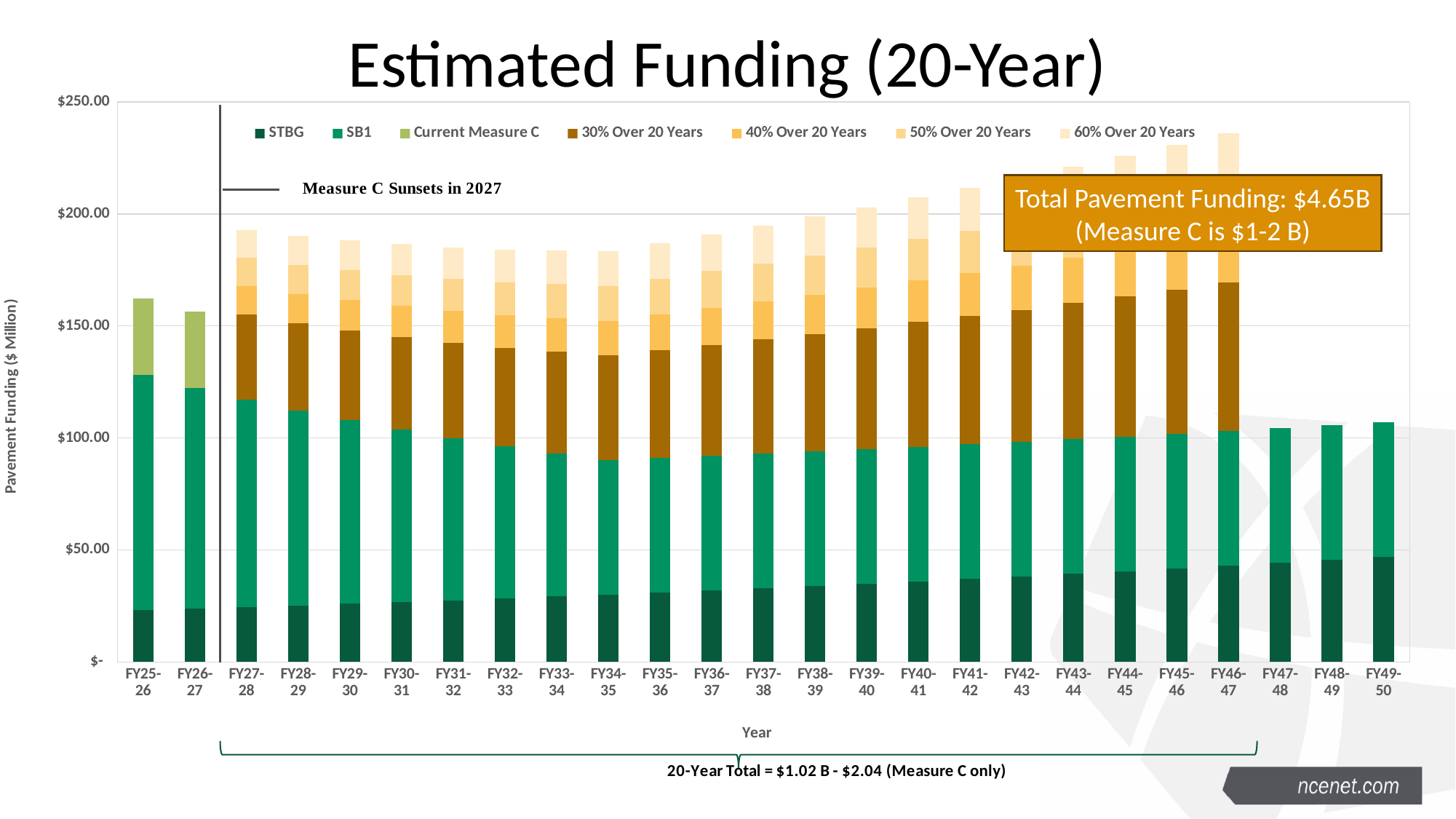
What is the title of the chart? Estimated Funding (20-Year) Is the total value for FY25-26 greater or less than $150.00? greater What is the label on the vertical axis? Pavement Funding ($ Million) How many series does the chart legend list? 7 Is the total value for FY46-47 greater or less than $200.00? greater Which fiscal year has the tallest stacked bar? FY46-47 What kind of chart is shown on the slide? Stacked bar chart Is the total value for FY27-28 greater or less than $200.00? less Do the total bar heights rise or fall from FY34-35 to FY46-47? Rise How many fiscal years are shown on the x axis? 25 Which has the larger total bar, FY46-47 or FY25-26? FY46-47